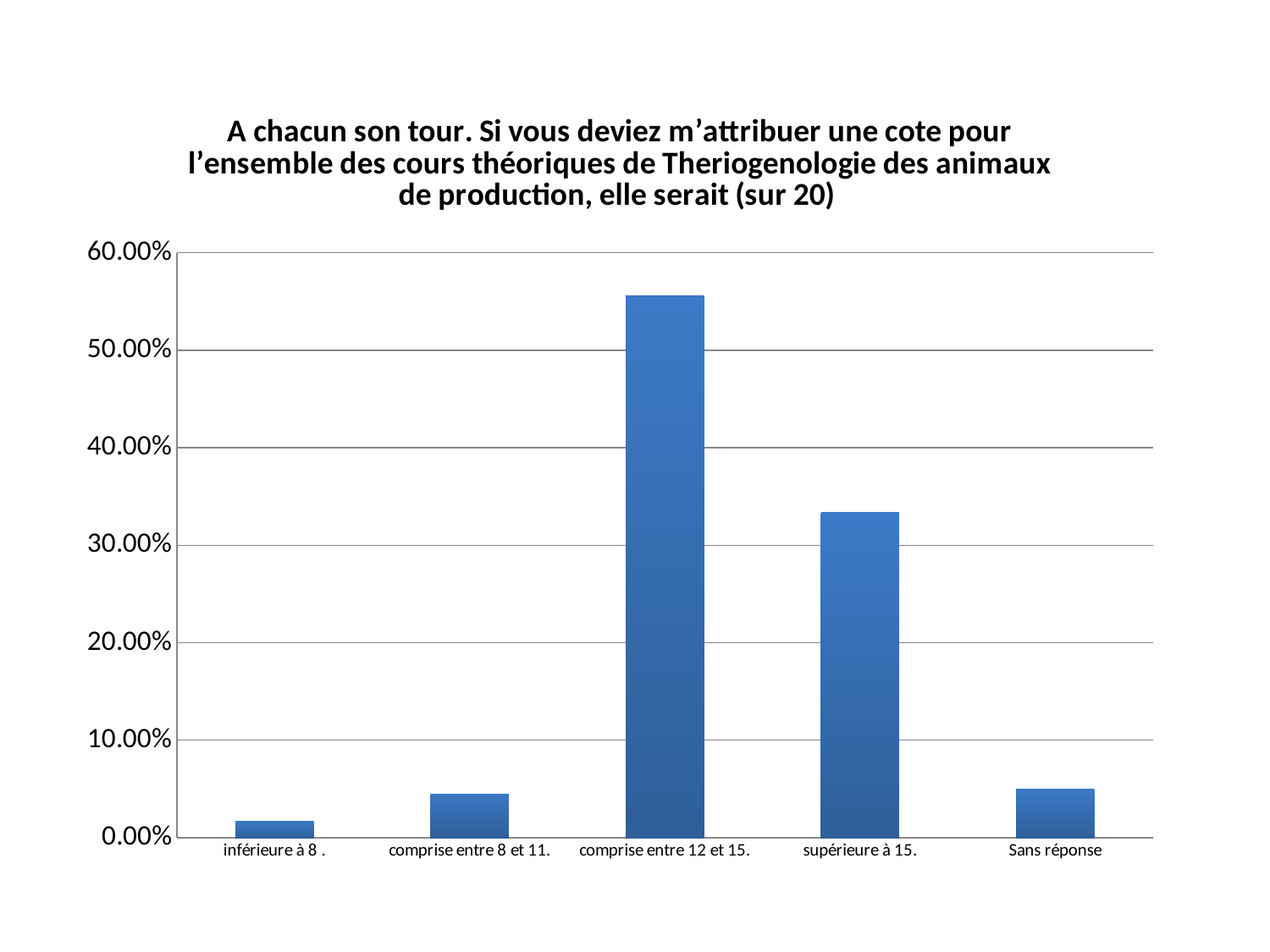
Is the value for "supérieure à 15." greater or less than 40.00%? less Which category has the highest value? comprise entre 12 et 15. Which is larger, the value for "inférieure à 8 ." or the value for "Sans réponse"? Sans réponse Is the value for "comprise entre 8 et 11." greater or less than 10.00%? less Is the value for "comprise entre 12 et 15." greater or less than 50.00%? greater Which is larger, the value for "comprise entre 12 et 15." or the value for "supérieure à 15."? comprise entre 12 et 15. How many categories are shown on the x axis? 5 Which category has the lowest value? inférieure à 8 . What is the highest value shown on the y axis? 60.00% What kind of chart is shown on the slide? bar chart